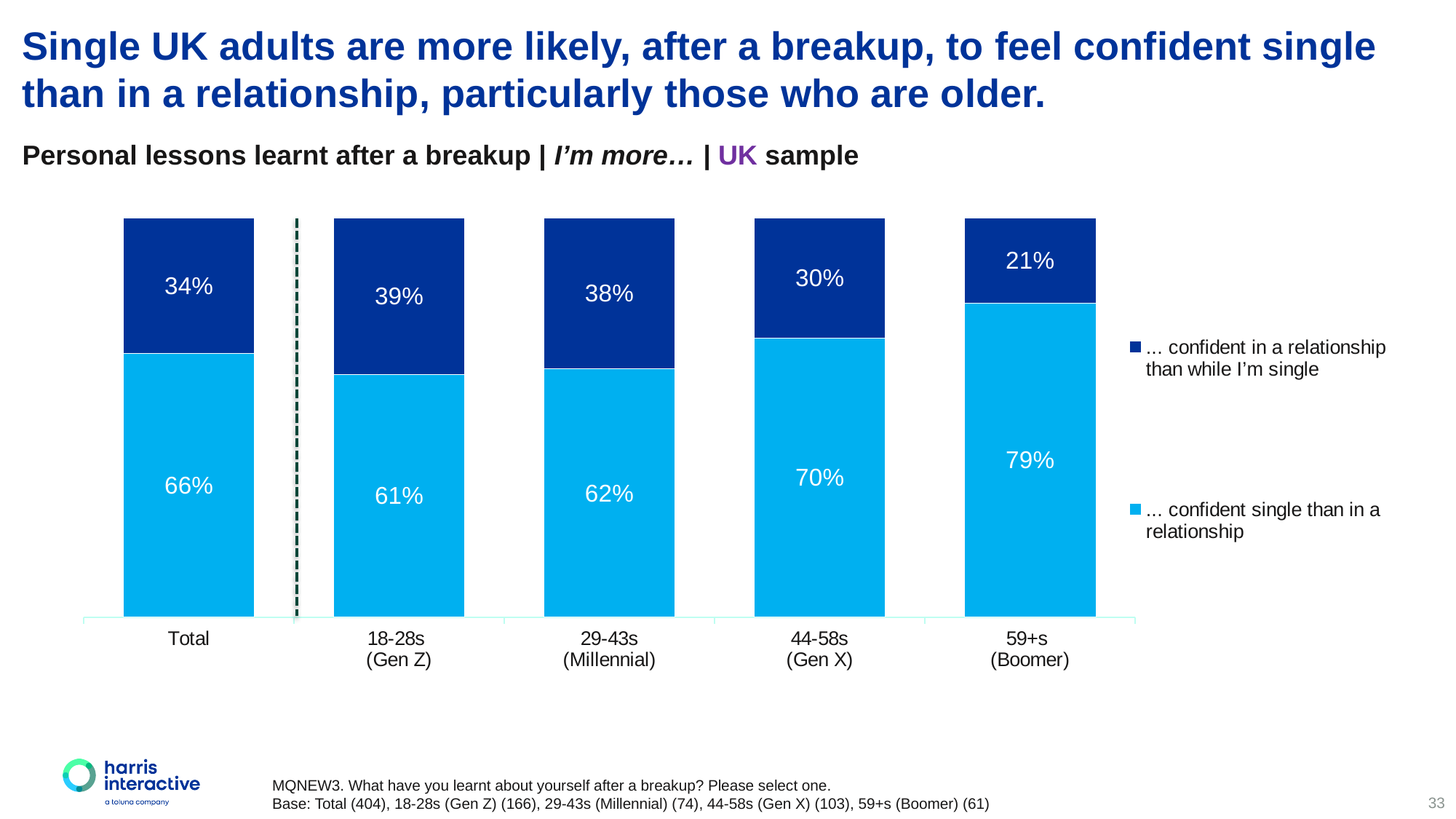
Which age group has the lowest share saying they are more confident single than in a relationship? 18-28s (Gen Z) Which is larger: the 'confident in a relationship' share for 18-28s (Gen Z) or for 44-58s (Gen X)? 18-28s (Gen Z) What kind of chart is shown on the slide? Stacked bar chart What percentage of 59+s (Boomer) say they are more confident in a relationship than while single? 21% What percentage of 44-58s (Gen X) say they are more confident single than in a relationship? 70% How many series does the legend list? 2 Which age group has the highest share saying they are more confident single than in a relationship? 59+s (Boomer) What is the total of the two segments for the 29-43s (Millennial) bar? 100% Moving from 18-28s (Gen Z) to 59+s (Boomer), does the 'confident single than in a relationship' share rise or fall? Rise What percentage of the Total sample say they are more confident single than in a relationship? 66% What is the difference between the 'confident single' share for 59+s (Boomer) and for 18-28s (Gen Z)? 18 percentage points How many age groups, including Total, are shown on the x axis? 5